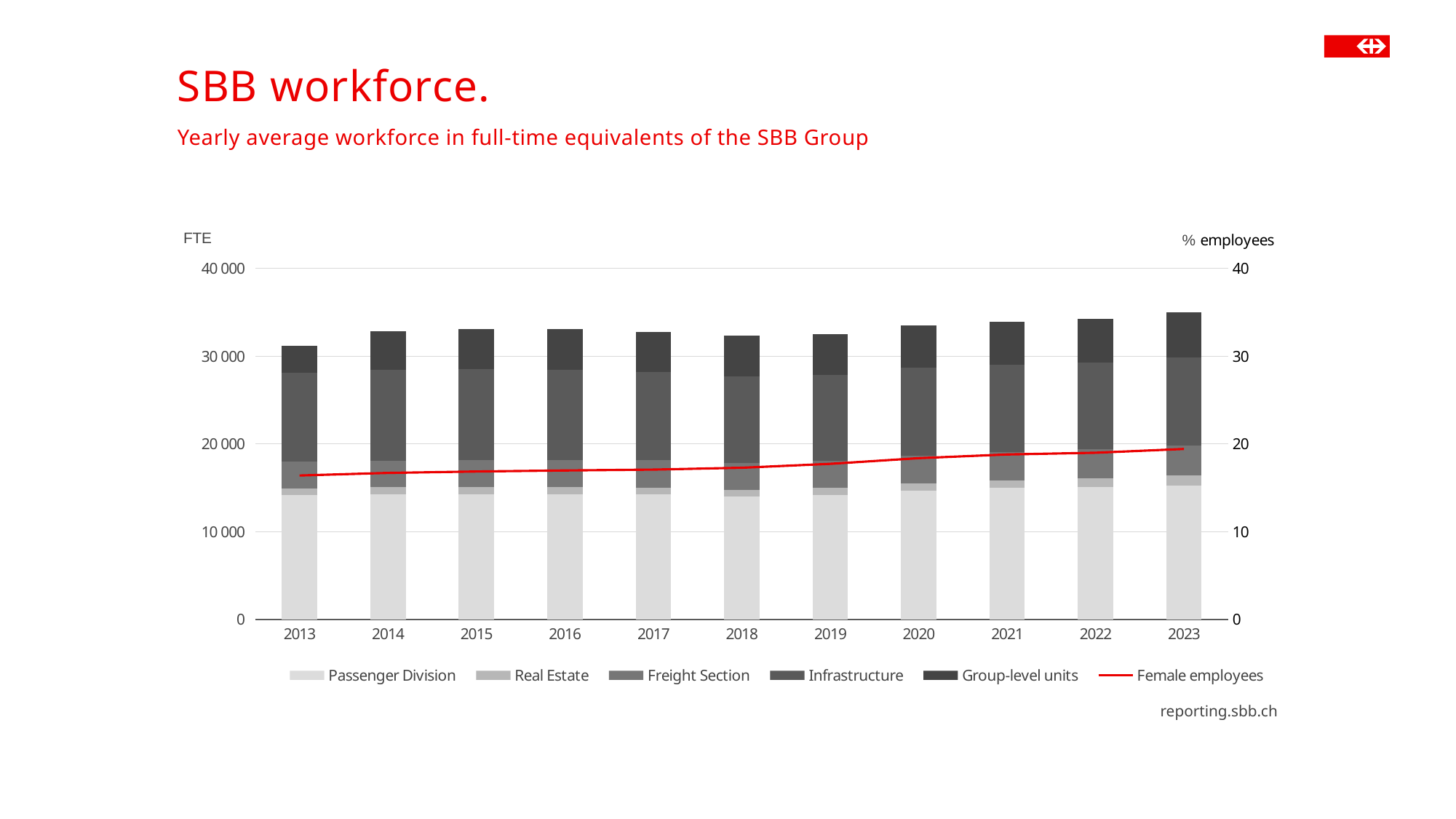
Does the share of female employees rise or fall from 2013 to 2023? rise Is the total workforce in 2023 greater or less than 30 000 FTE? greater Which year has the lowest total workforce (shortest stacked bar)? 2013 What kind of chart is shown on the slide? Stacked bar chart with a line Which year has the highest total workforce (tallest stacked bar)? 2023 Which year has the larger total workforce, 2018 or 2021? 2021 What is the label of the right-hand vertical axis? % employees Is the share of female employees in 2013 greater or less than 20%? less Is the total workforce in 2018 greater or less than 40 000 FTE? less How many years are shown on the x axis of the chart? 11 How many series does the chart's legend list? 6 Which series is drawn as a red line in the chart? Female employees